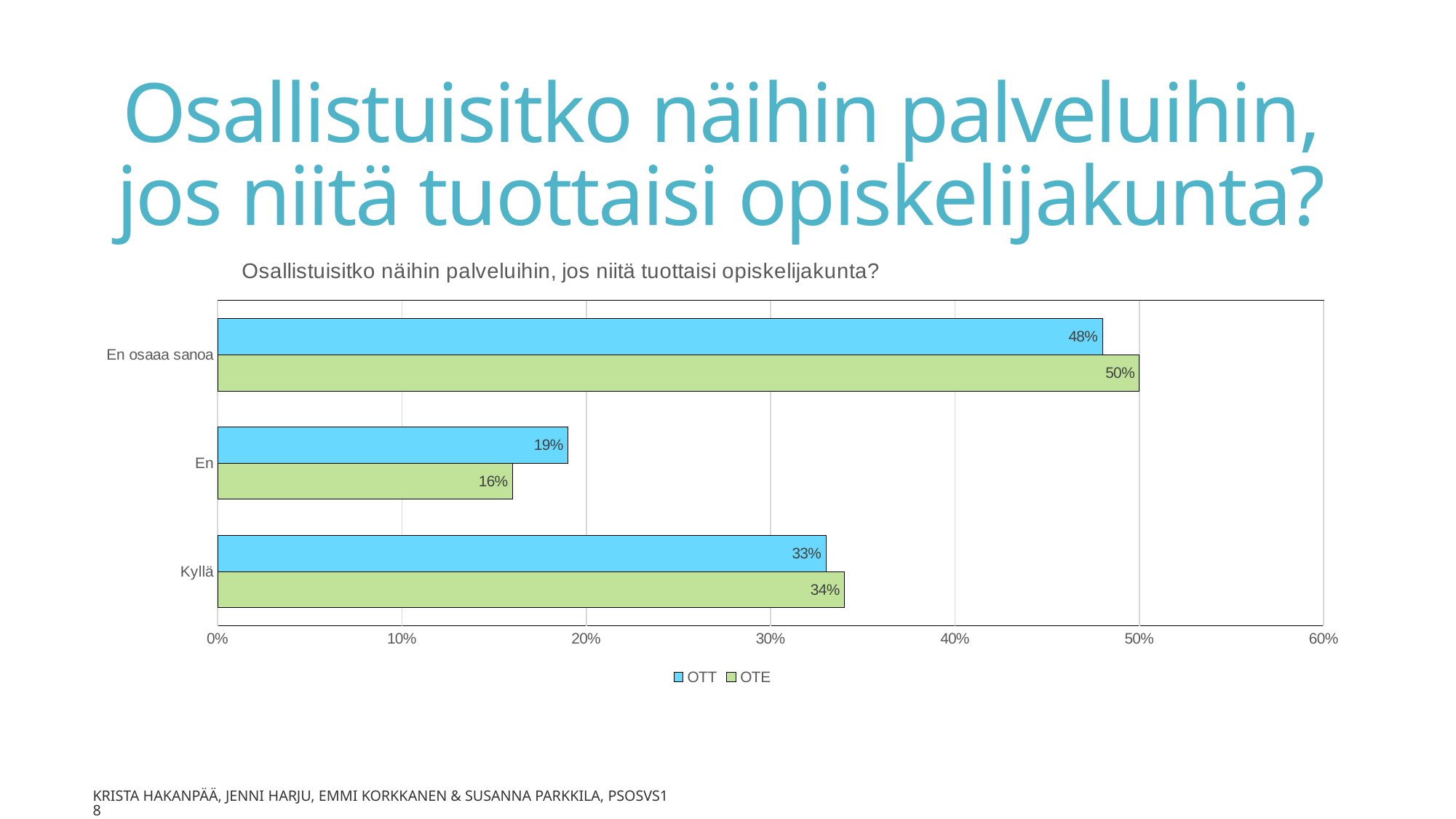
Is the OTT value for "Kyllä" greater or less than 40%? less Which is larger for "En osaaa sanoa": the OTT value or the OTE value? OTE What kind of chart is shown on the slide? bar chart What is the OTT value for "En osaaa sanoa"? 48% Which category has the highest OTE value? En osaaa sanoa Which series is shown in green? OTE Which category has the lowest OTT value? En How many categories are shown on the chart? 3 What is the OTE value for "Kyllä"? 34% What is the difference between the OTT and OTE values for "En"? 3% How many series does the legend list? 2 What is the OTE value for "En"? 16%